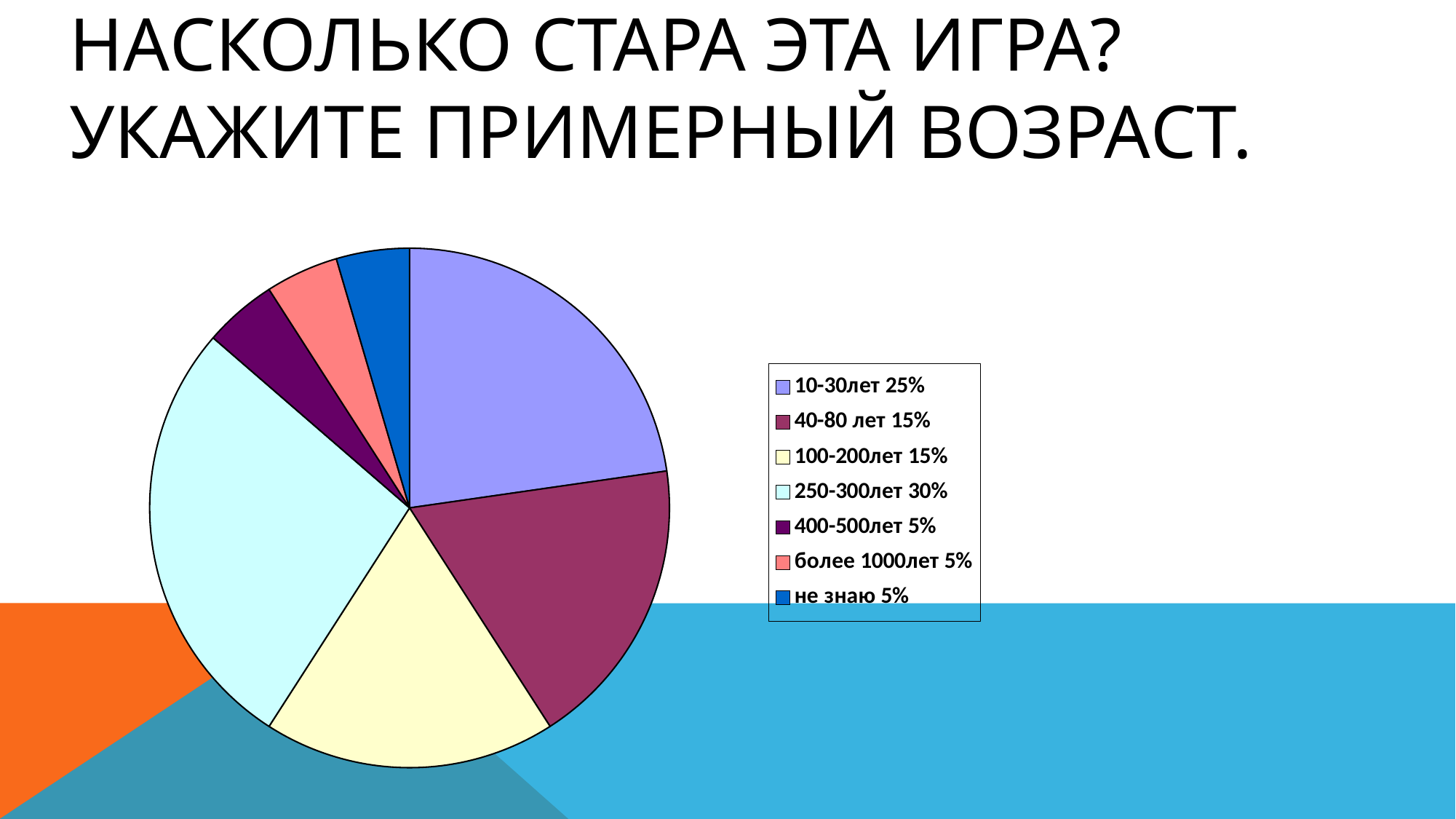
What is the difference between the shares for "100-200лет" and "400-500лет"? 10% What share of the pie does the "250-300лет" slice represent? 30% What is the combined share of "400-500лет", "более 1000лет" and "не знаю"? 15% Which is larger, the share for "10-30лет" or the share for "100-200лет"? 10-30лет What kind of chart is shown on the slide? pie chart What is the value for "40-80 лет"? 15% What colour is the slice for "250-300лет"? light cyan What share of the pie does the "10-30лет" slice represent? 25% What is the difference between the shares for "250-300лет" and "10-30лет"? 5% Which category has the largest share of the pie? 250-300лет What is the value for "не знаю"? 5% How many categories does the legend list? 7